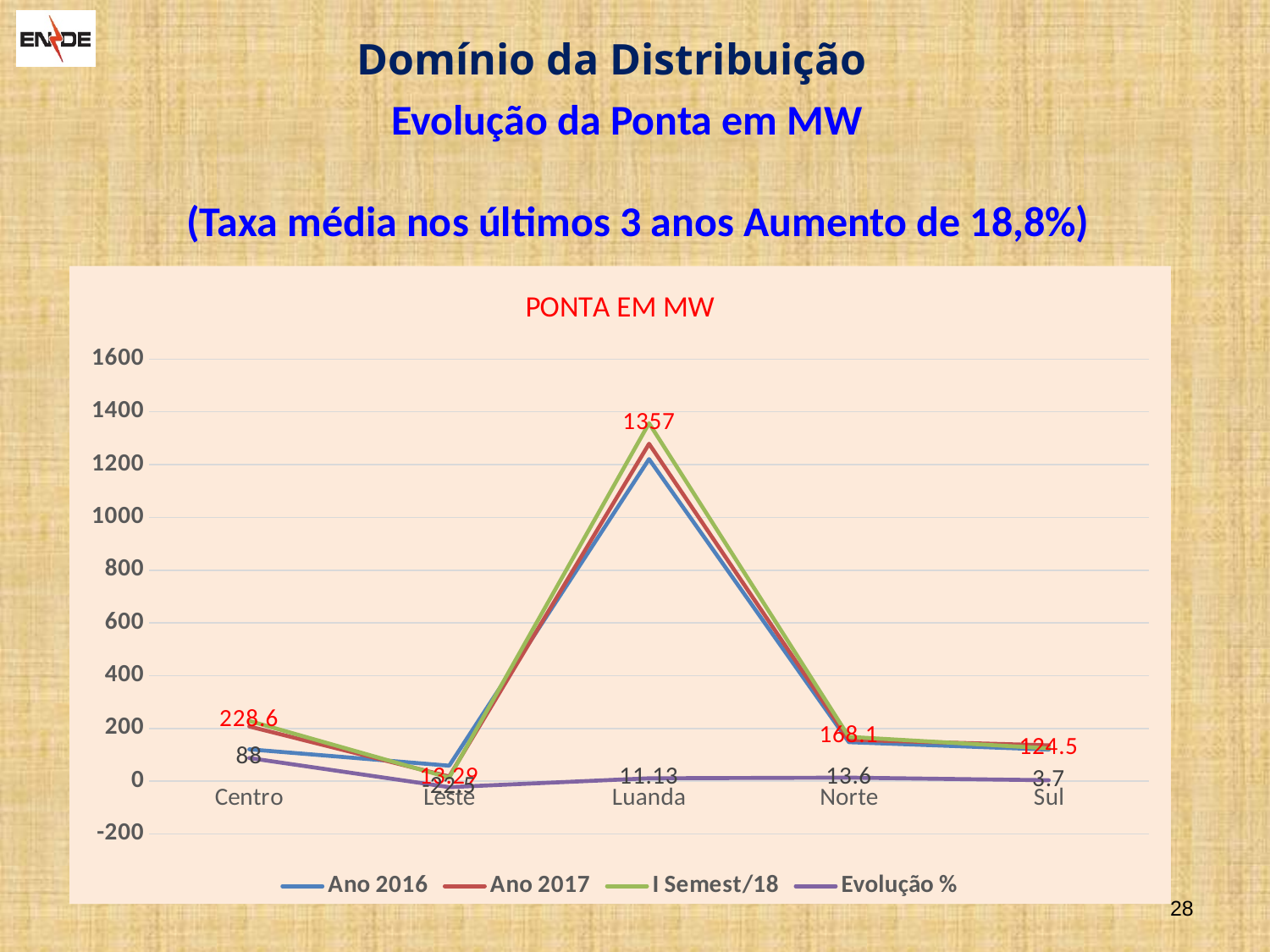
How many regions are shown on the x axis of the chart? 5 How many series does the chart legend list? 4 What is the Evolução % value for Centro? 88 Which region has the lowest Evolução % value? Leste What is the Evolução % value for Norte? 13.6 Which region has the highest peak (ponta) values in the chart? Luanda What is the title of the chart? PONTA EM MW Is the Ano 2016 value for Luanda greater or less than 1000? greater What is the difference between the Evolução % values for Norte and Sul? 9.9 What is the Evolução % value for Leste? -22.5 What kind of chart is shown on the slide? line chart What is the Evolução % value for Sul? 3.7